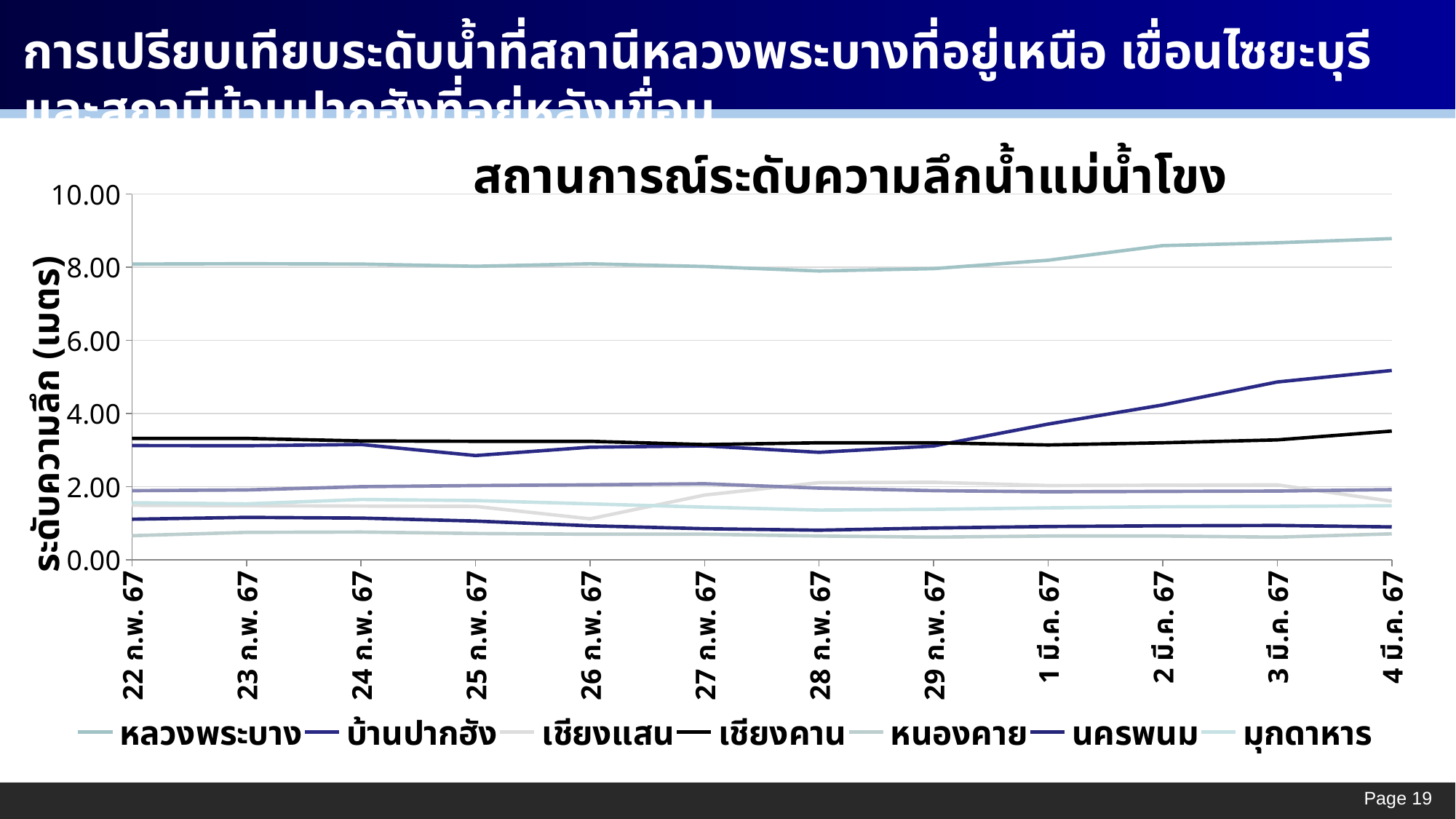
How many series does the legend of the chart list? 7 Is the value for หลวงพระบาง on 4 มี.ค. 67 greater or less than 8.00? greater How many dates are shown along the x axis of the chart? 12 Which series has the highest values across the whole chart? หลวงพระบาง On 4 มี.ค. 67, which is larger: the value for หลวงพระบาง or the value for บ้านปากฮัง? หลวงพระบาง What is the label of the vertical axis of the chart? ระดับความลึก (เมตร) Is the value for บ้านปากฮัง on 4 มี.ค. 67 greater or less than 4.00? greater Is the value for บ้านปากฮัง on 25 ก.พ. 67 greater or less than 4.00? less Does the value for บ้านปากฮัง rise or fall from 29 ก.พ. 67 to 4 มี.ค. 67? rise What kind of chart is shown on the slide? line chart What is the title of the chart? สถานการณ์ระดับความลึกน้ำแม่น้ำโขง